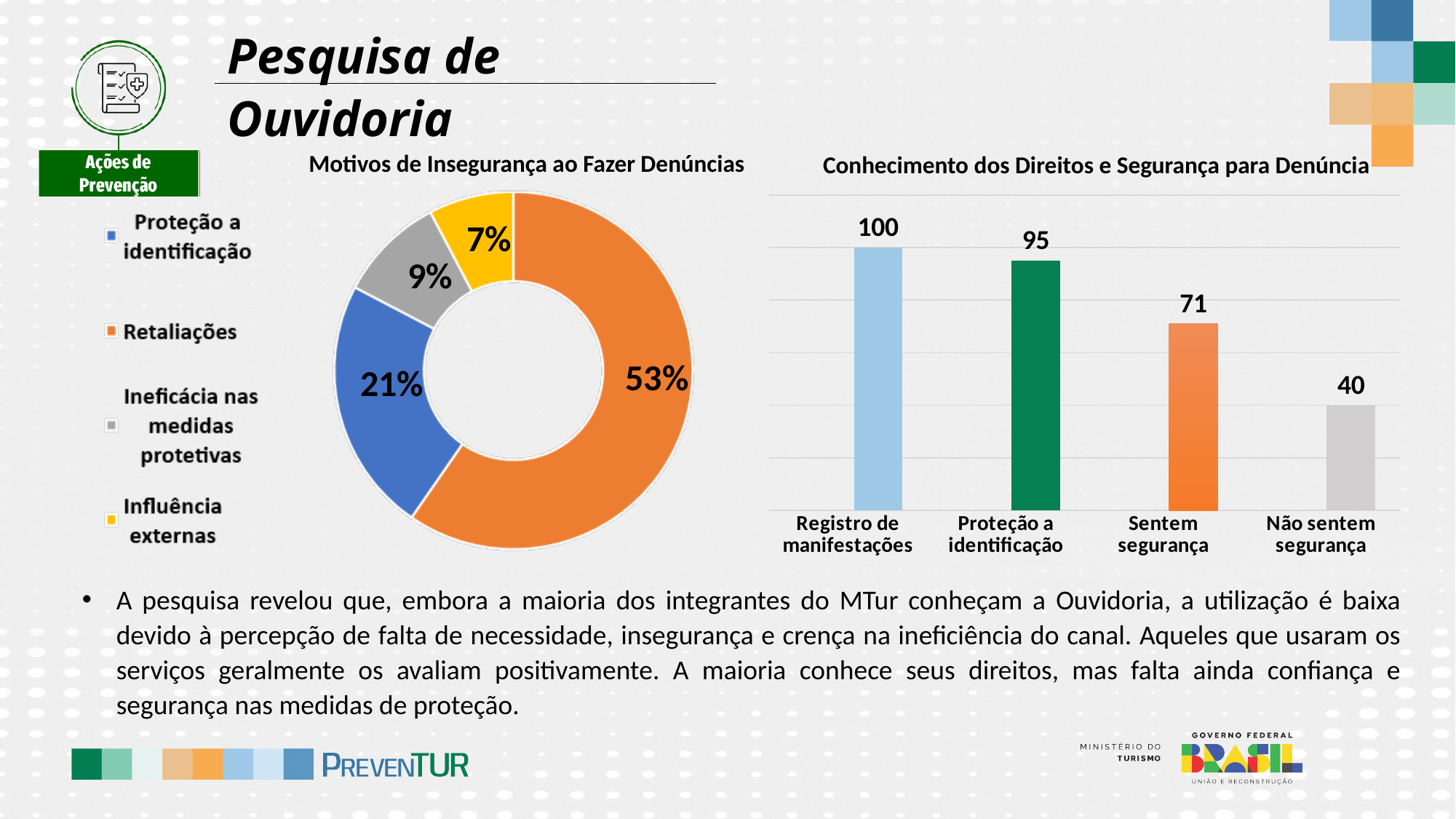
In the chart 'Motivos de Insegurança ao Fazer Denúncias', how many categories does the legend list? 4 In the chart 'Conhecimento dos Direitos e Segurança para Denúncia', what is the value for Não sentem segurança? 40 In the chart 'Conhecimento dos Direitos e Segurança para Denúncia', which category has the highest value? Registro de manifestações In the chart 'Motivos de Insegurança ao Fazer Denúncias', which category has the smallest share? Influência externas What type of chart is 'Motivos de Insegurança ao Fazer Denúncias'? Pie chart (donut) In the chart 'Conhecimento dos Direitos e Segurança para Denúncia', what is the value for Sentem segurança? 71 What type of chart is 'Conhecimento dos Direitos e Segurança para Denúncia'? Bar chart In the chart 'Motivos de Insegurança ao Fazer Denúncias', what percentage is shown for Proteção a identificação? 21% In the chart 'Motivos de Insegurança ao Fazer Denúncias', what percentage is shown for Retaliações? 53% In the chart 'Conhecimento dos Direitos e Segurança para Denúncia', what is the difference between Proteção a identificação and Não sentem segurança? 55 In the chart 'Motivos de Insegurança ao Fazer Denúncias', what is the difference in percentage points between Retaliações and Proteção a identificação? 32 In the chart 'Conhecimento dos Direitos e Segurança para Denúncia', do the values rise or fall from left to right? Fall